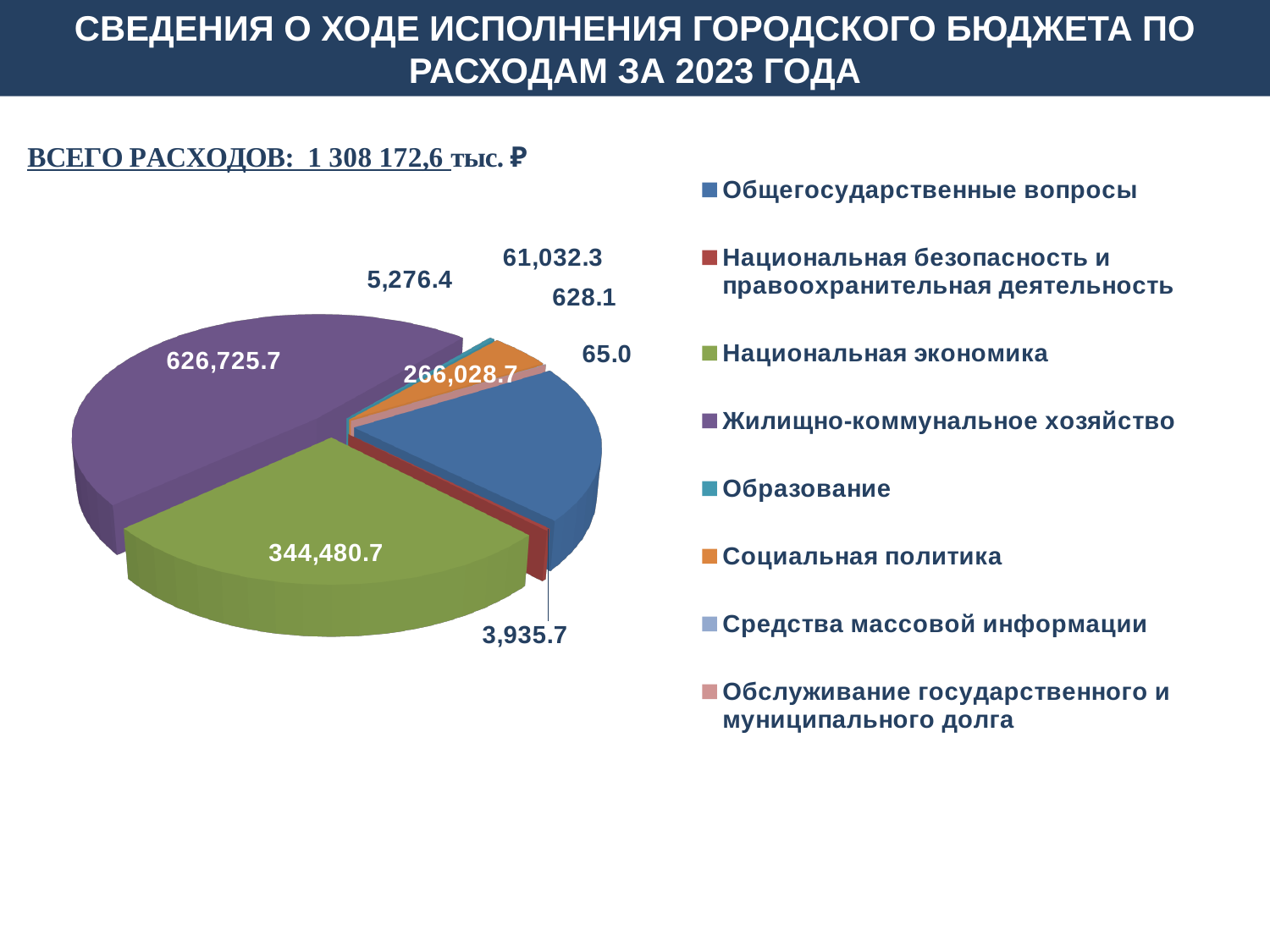
What is the difference between the values for Жилищно-коммунальное хозяйство and Национальная экономика? 282,245.0 What is the value shown for Жилищно-коммунальное хозяйство? 626,725.7 What is the value shown for Национальная безопасность и правоохранительная деятельность? 3,935.7 What is the smallest value labelled on the pie chart? 65.0 Which is larger, the value for Общегосударственные вопросы or the value for Социальная политика? Общегосударственные вопросы What total expenditure (ВСЕГО РАСХОДОВ) is stated on the slide? 1 308 172,6 тыс. ₽ What is the value shown for Национальная экономика? 344,480.7 What is the value shown for Общегосударственные вопросы? 266,028.7 How many categories does the legend of the pie chart list? 8 Which category has the largest slice of the pie? Жилищно-коммунальное хозяйство What kind of chart is shown on the slide? Pie chart What is the value shown for Социальная политика? 61,032.3